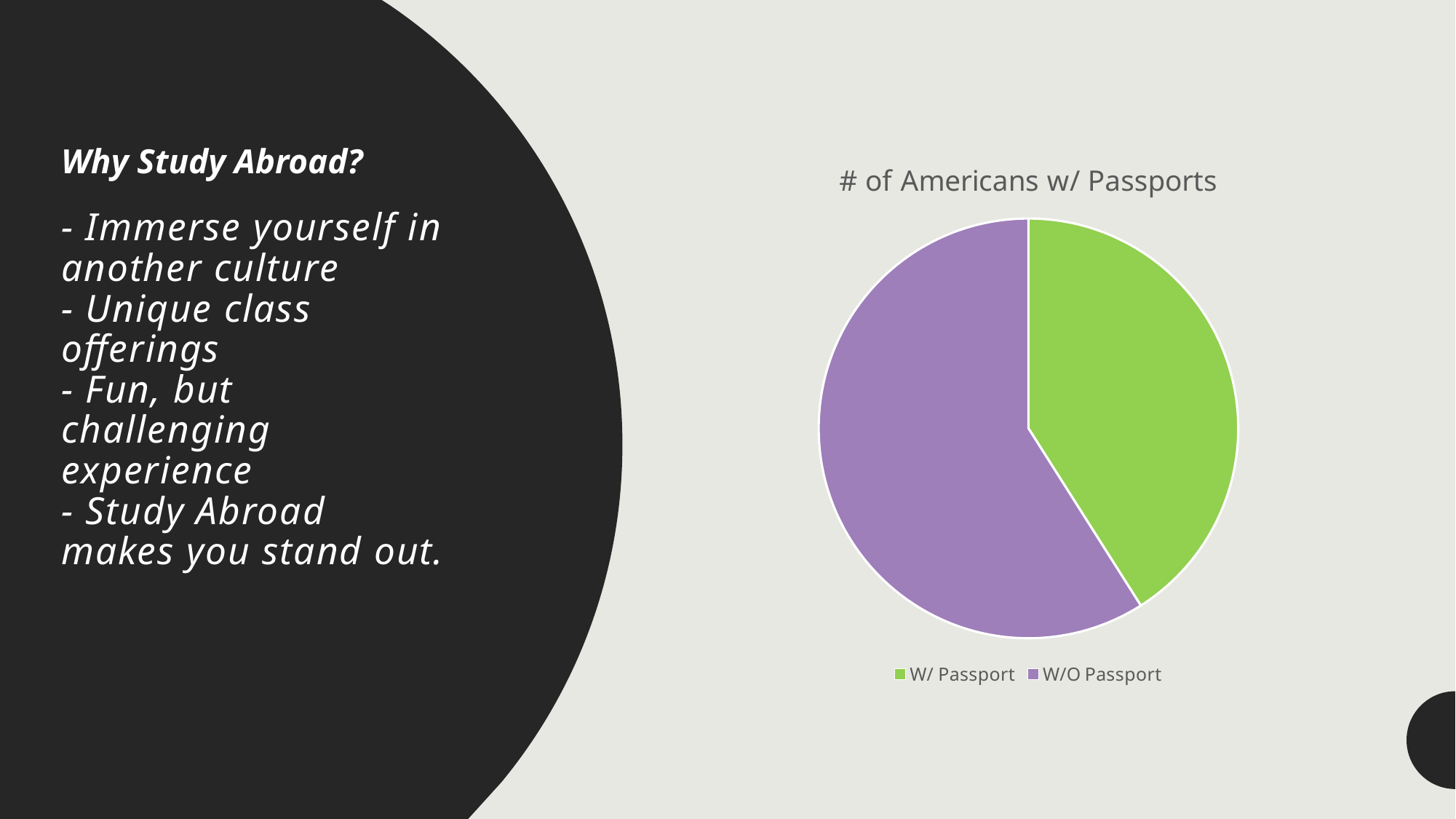
Which category has the largest slice of the pie? W/O Passport How many slices does the pie chart have? 2 How many entries does the chart legend list? 2 Does the W/O Passport slice take up more or less than half of the pie? More Which slice is larger, W/ Passport or W/O Passport? W/O Passport What colour is the W/ Passport slice? Green Which category has the smallest slice of the pie? W/ Passport What kind of chart is shown on the slide? Pie chart What is the title of the chart? # of Americans w/ Passports